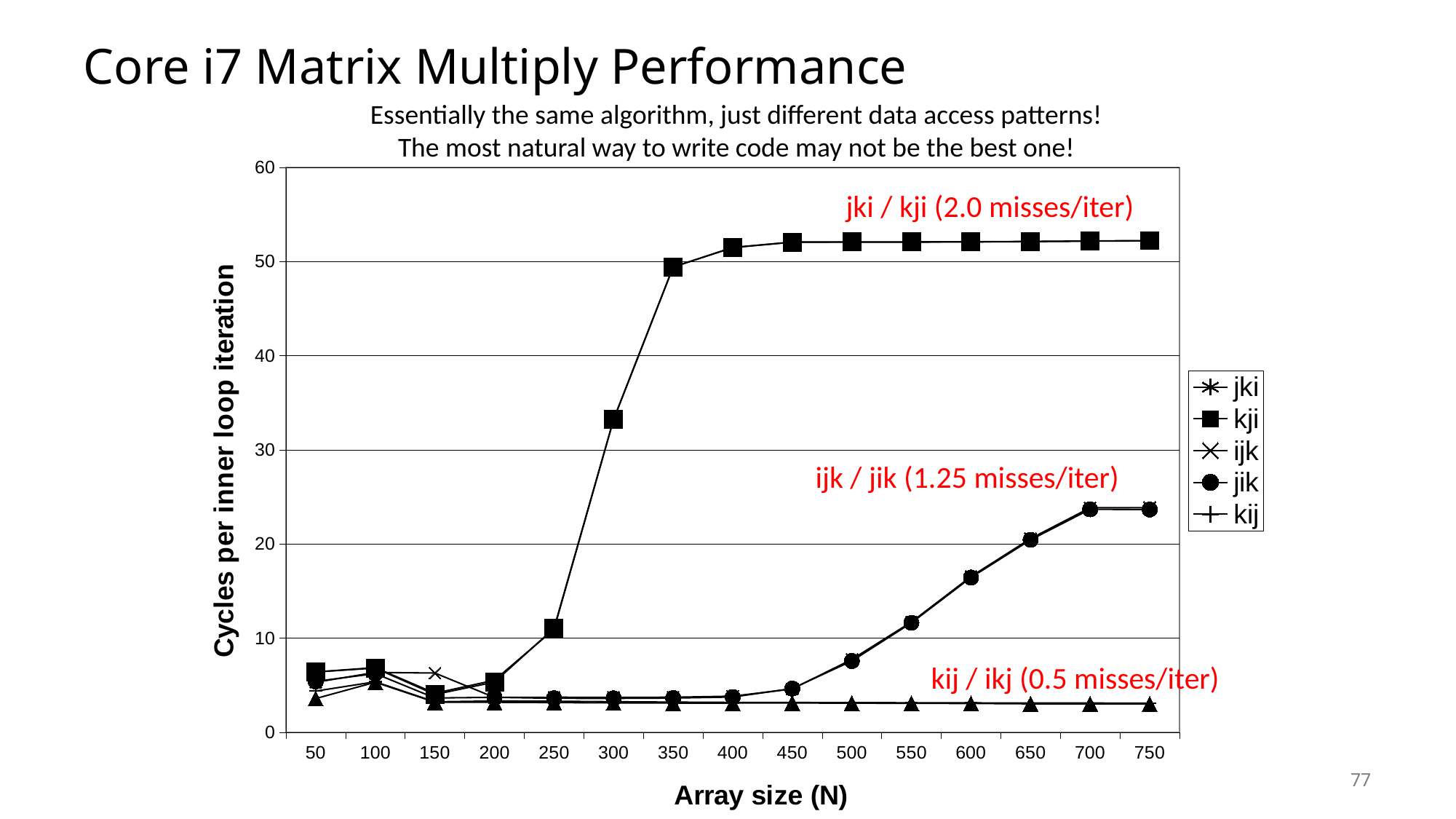
What kind of chart is shown on the slide? line chart Is the value for jik at array size 500 greater or less than 10? less At array size 600, which is larger, the value for kji or the value for jik? kji Is the value for jik at array size 700 greater or less than 20? greater How many array size values are marked along the x axis? 15 Does the kji series rise or fall between array sizes 200 and 400? rise What is the label of the y axis? Cycles per inner loop iteration Is the value for kij at array size 750 greater or less than 10? less How many series does the legend list? 5 Which series has the highest value at array size 750? kji